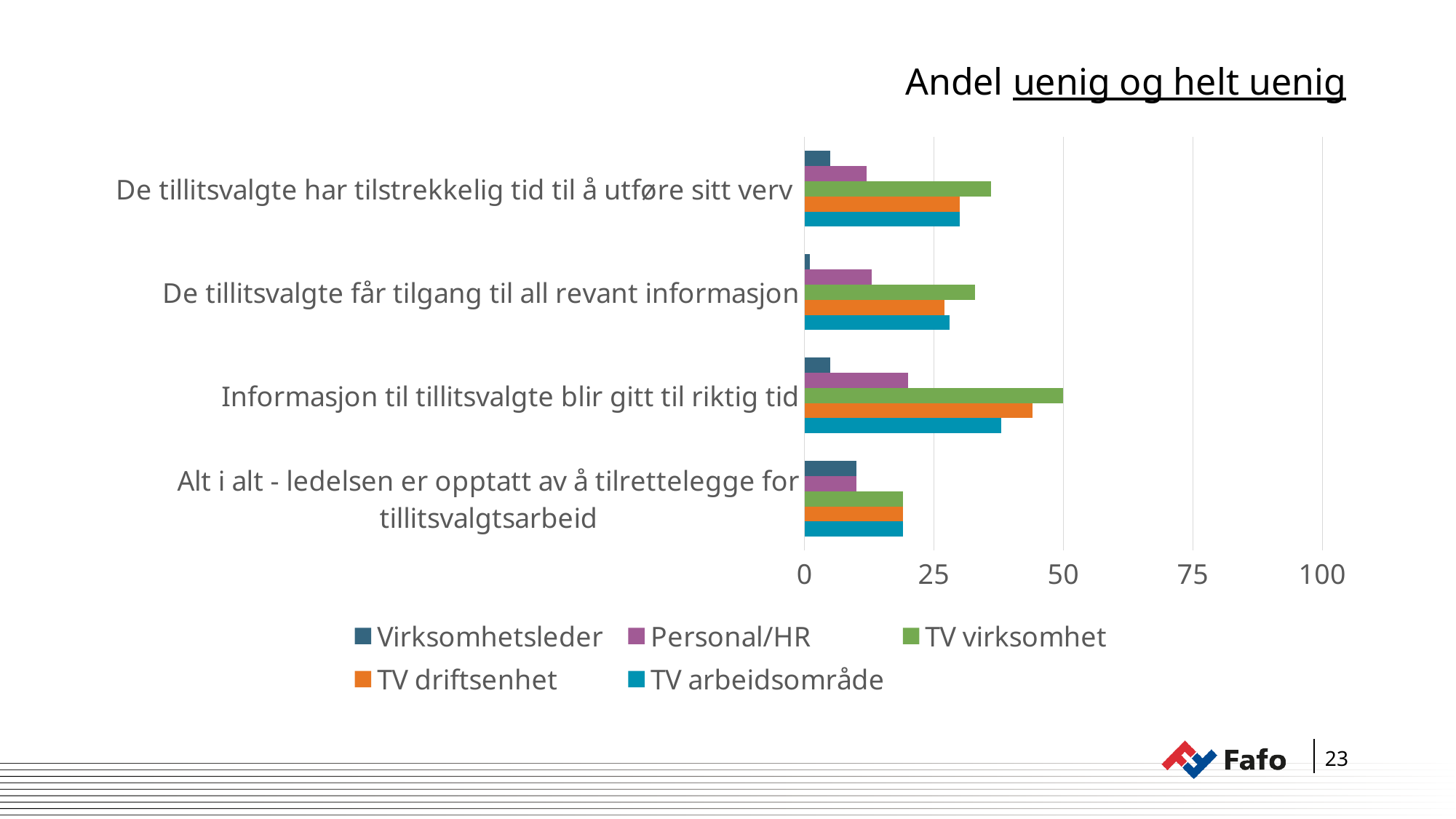
For which category is the TV virksomhet value lowest? Alt i alt - ledelsen er opptatt av å tilrettelegge for tillitsvalgtsarbeid Which colour represents the series TV driftsenhet in the chart? Orange For which category is the TV virksomhet value highest? Informasjon til tillitsvalgte blir gitt til riktig tid Is the Personal/HR value larger for 'Informasjon til tillitsvalgte blir gitt til riktig tid' or for 'De tillitsvalgte har tilstrekkelig tid til å utføre sitt verv'? Informasjon til tillitsvalgte blir gitt til riktig tid How many categories are shown on the vertical axis of the chart? 4 How many series does the legend list? 5 Is the Virksomhetsleder value for 'De tillitsvalgte får tilgang til all revant informasjon' greater or less than 25? less What is the title of the chart? Andel uenig og helt uenig Is the TV driftsenhet value for 'Informasjon til tillitsvalgte blir gitt til riktig tid' greater or less than 50? less Is the TV virksomhet value for 'De tillitsvalgte har tilstrekkelig tid til å utføre sitt verv' greater or less than 25? greater For 'De tillitsvalgte har tilstrekkelig tid til å utføre sitt verv', which is larger: the Virksomhetsleder value or the TV virksomhet value? TV virksomhet What kind of chart is shown on the slide? Bar chart